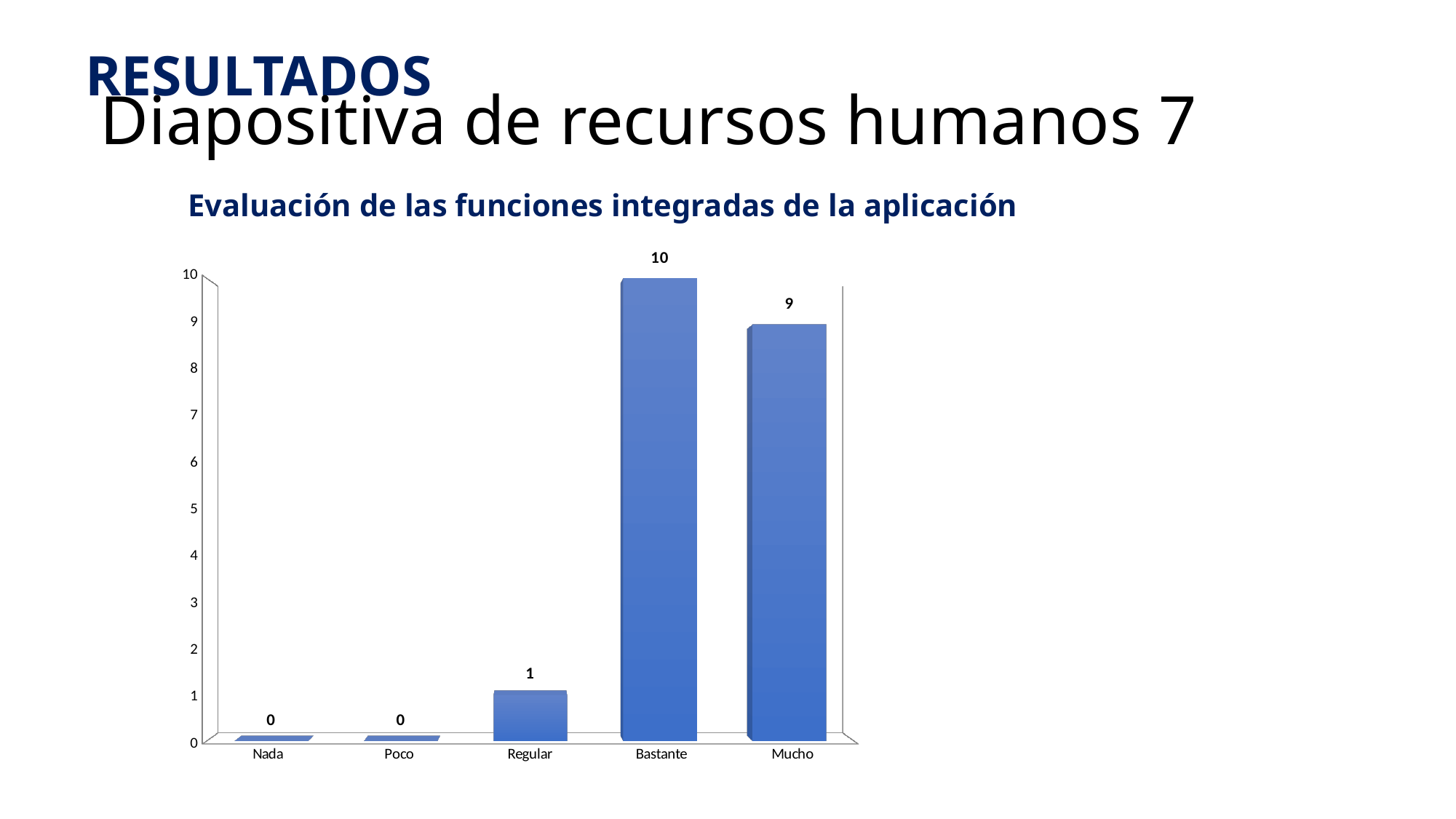
What is the difference between the values for Mucho and Regular? 8 Is the value for Bastante greater or less than 5? greater What is the difference between the values for Bastante and Mucho? 1 What is the value for Regular? 1 What is the value for Nada? 0 What is the value for Bastante? 10 What is the value for Mucho? 9 What kind of chart is shown on the slide? bar chart What is the title of the chart? Evaluación de las funciones integradas de la aplicación Which category has the highest value? Bastante Which is larger, the value for Regular or the value for Mucho? Mucho How many categories are shown on the x axis? 5